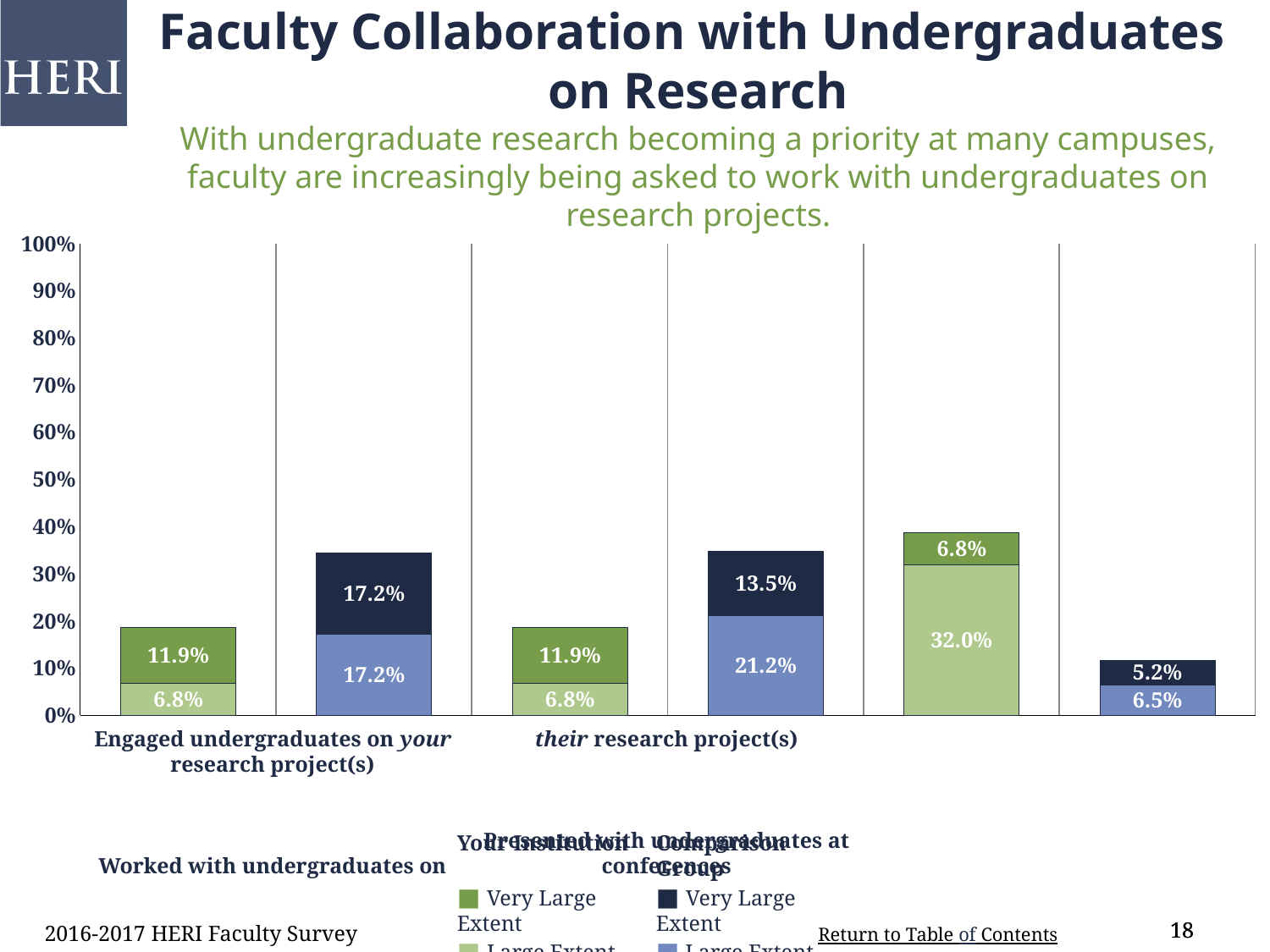
For 'Engaged undergraduates on your research project(s)', what is the Large Extent value for Your Institution? 6.8% In the rightmost pair of bars, is the total stacked bar for Your Institution greater or less than 30%? greater For 'Worked with undergraduates on their research project(s)', what is the Very Large Extent value for the Comparison Group? 13.5% For 'Engaged undergraduates on your research project(s)', what is the Very Large Extent value for the Comparison Group? 17.2% What is the total of the Comparison Group stacked bar for 'Engaged undergraduates on your research project(s)'? 34.4% For 'Engaged undergraduates on your research project(s)', which is larger: the Very Large Extent value for Your Institution or for the Comparison Group? Comparison Group In the rightmost pair of bars, what is the Large Extent value for Your Institution? 32.0% What type of chart is shown on the slide? stacked bar chart For 'Engaged undergraduates on your research project(s)', what is the Very Large Extent value for Your Institution? 11.9% What is the total of the Your Institution stacked bar for 'Engaged undergraduates on your research project(s)'? 18.7% For 'Worked with undergraduates on their research project(s)', what is the Large Extent value for the Comparison Group? 21.2% In the rightmost pair of bars, what is the difference between the Large Extent value for Your Institution (32.0%) and the Large Extent value for the Comparison Group (6.5%)? 25.5%